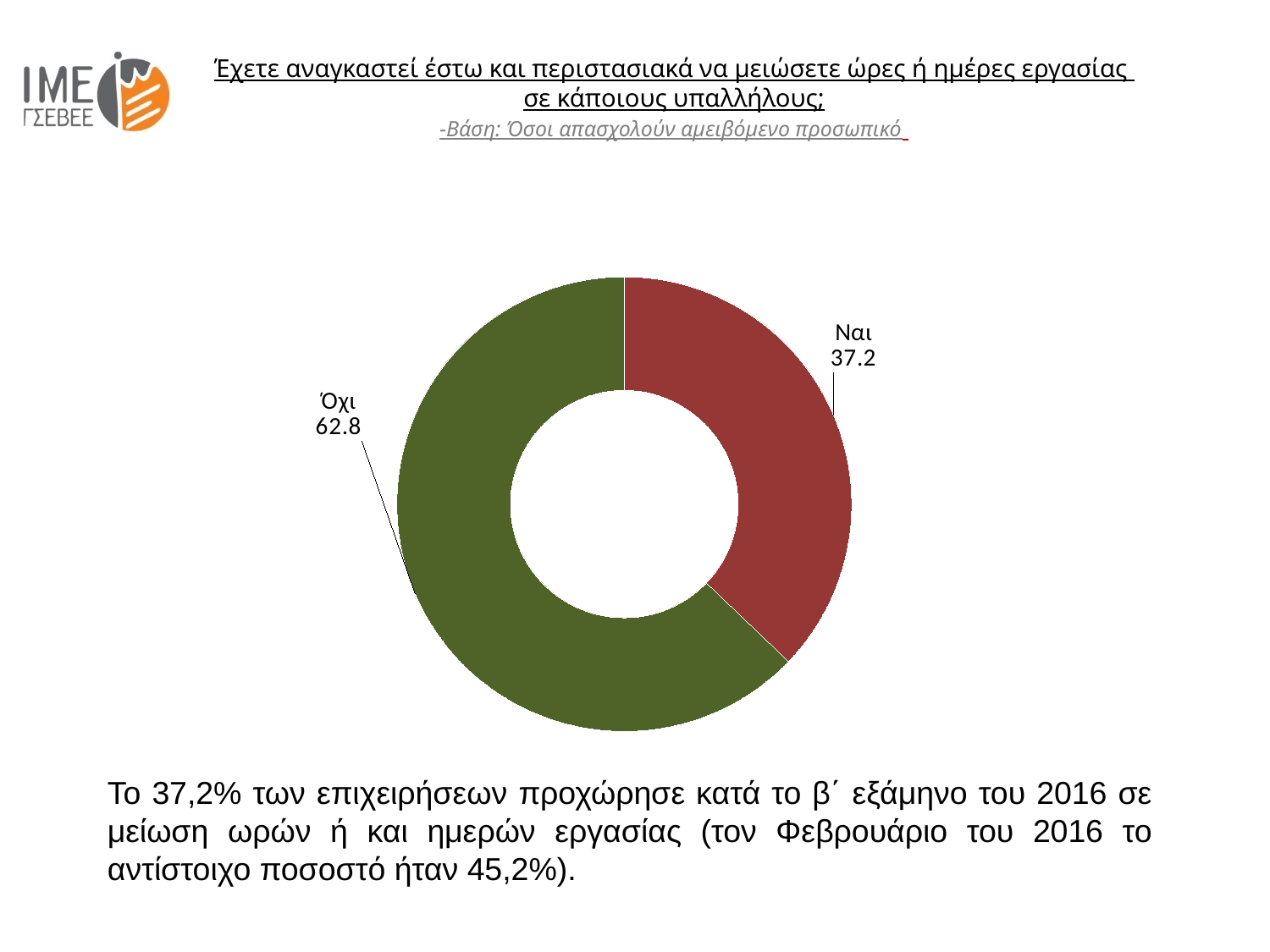
Which category has the smallest share? Ναι Which is larger, the value for Ναι or the value for Όχι? Όχι What is the difference between the values for Όχι and Ναι? 25.6 What is the value for Ναι? 37.2 What colour is the Όχι slice? Green Which category has the largest share? Όχι What is the total of the two slice values? 100 What colour is the Ναι slice? Red How many categories does the chart show? 2 What kind of chart is shown on the slide? Doughnut (pie) chart What is the value for Όχι? 62.8